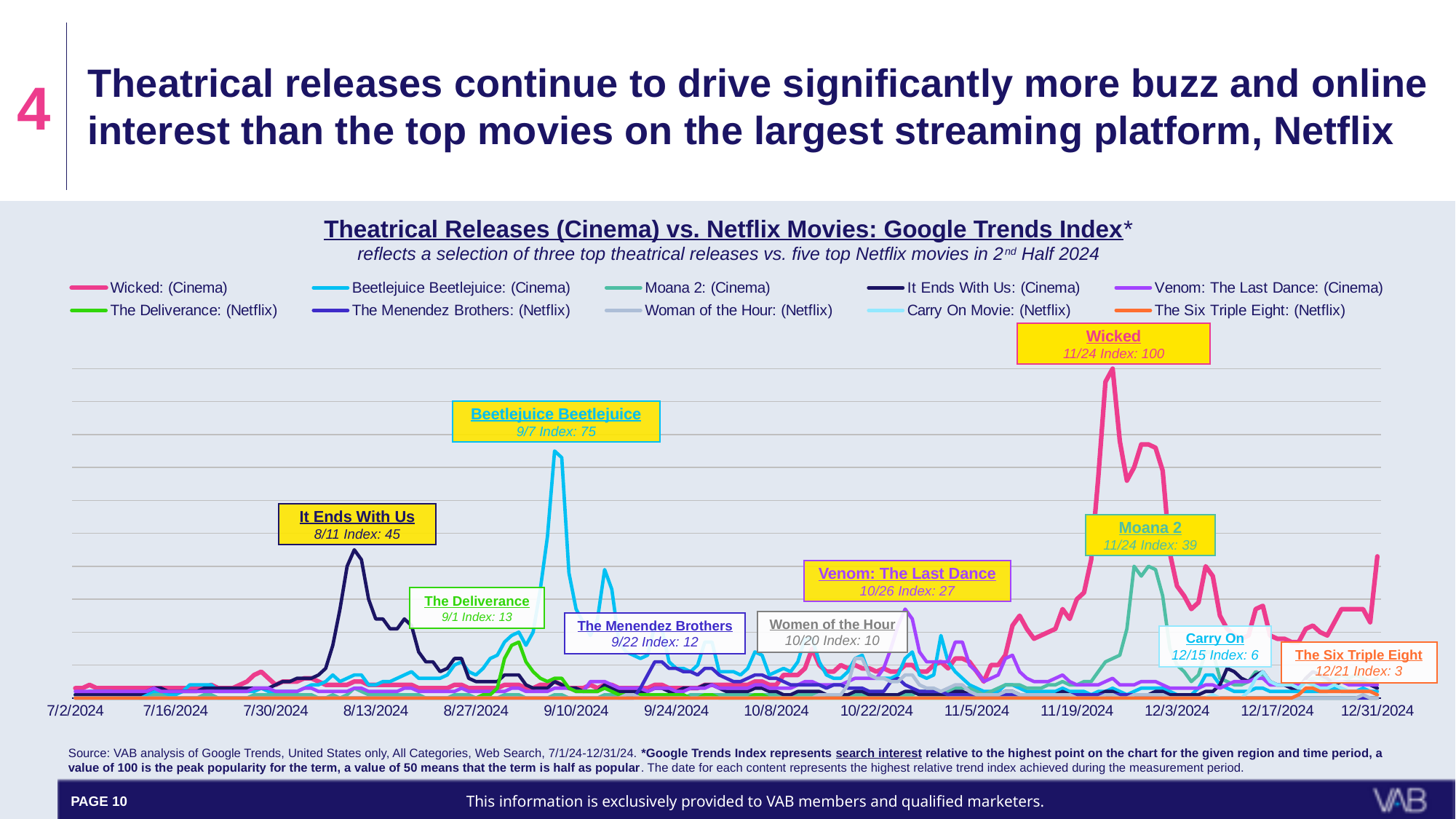
What is the difference between the peak index of Wicked and the peak index of Beetlejuice Beetlejuice? 25 What is the peak Google Trends Index value for Wicked? 100 Which movie has the highest peak index on the chart? Wicked How many series does the legend list? 10 What is the peak index value for The Six Triple Eight? 3 What is the title of the chart? Theatrical Releases (Cinema) vs. Netflix Movies: Google Trends Index What is the difference between the peak index of The Deliverance and the peak index of The Menendez Brothers? 1 Which movie has the lowest peak index on the chart? The Six Triple Eight What is the peak index value for It Ends With Us? 45 On what date did Beetlejuice Beetlejuice reach its peak index of 75? 9/7 Which has a higher peak index, Moana 2 or Venom: The Last Dance? Moana 2 What type of chart is shown on the slide? line chart